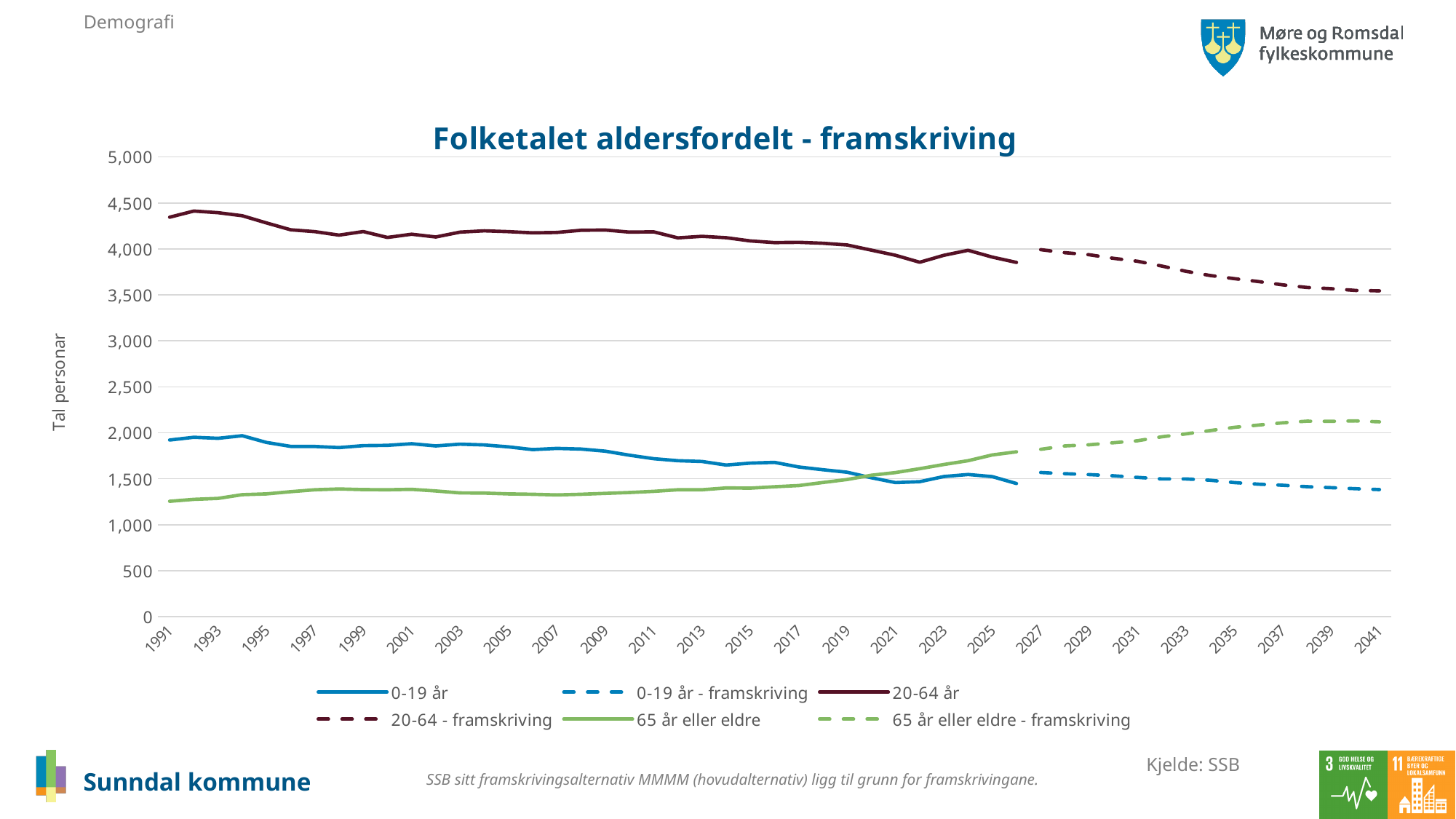
In 2025, which is larger: 65 år eller eldre or 0-19 år? 65 år eller eldre Does the 65 år eller eldre series rise or fall from 2007 to 2025? rise Is the value for 0-19 år in 1991 greater or less than 2,000? less Is the value for 65 år eller eldre in 1991 greater or less than 1,500? less Is the value for 20-64 år in 1991 greater or less than 4,000? greater What kind of chart is shown on the slide? line chart How many series does the legend list? 6 What is the title of the chart? Folketalet aldersfordelt - framskriving Does the 20-64 år series rise or fall from 1991 to 2025? fall What is the label on the vertical axis? Tal personar